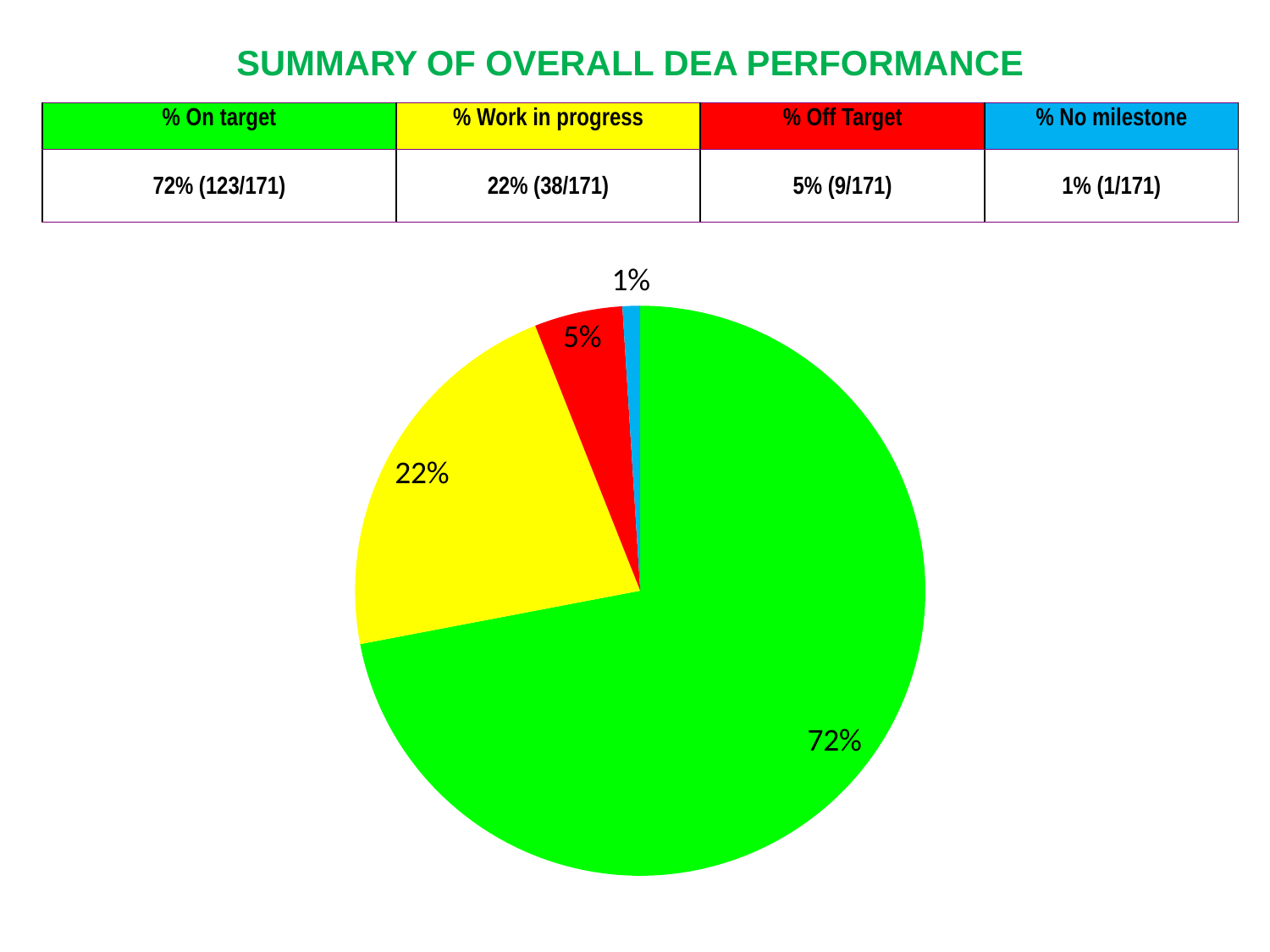
What share of the pie does the green slice (% On target) represent? 72% What is the difference in percentage points between the red slice (5%) and the blue slice (1%)? 4 What is the difference in percentage points between the green slice (72%) and the yellow slice (22%)? 50 What share of the pie does the red slice (% Off Target) represent? 5% How many slices does the pie chart have? 4 Which slice of the pie chart is the smallest? 1% (blue, % No milestone) Which slice of the pie chart is the largest? 72% (green, % On target) Which is larger, the red slice or the yellow slice? the yellow slice What kind of chart is shown on the slide? pie chart What share of the pie does the blue slice (% No milestone) represent? 1% What is the title shown above the chart on the slide? SUMMARY OF OVERALL DEA PERFORMANCE